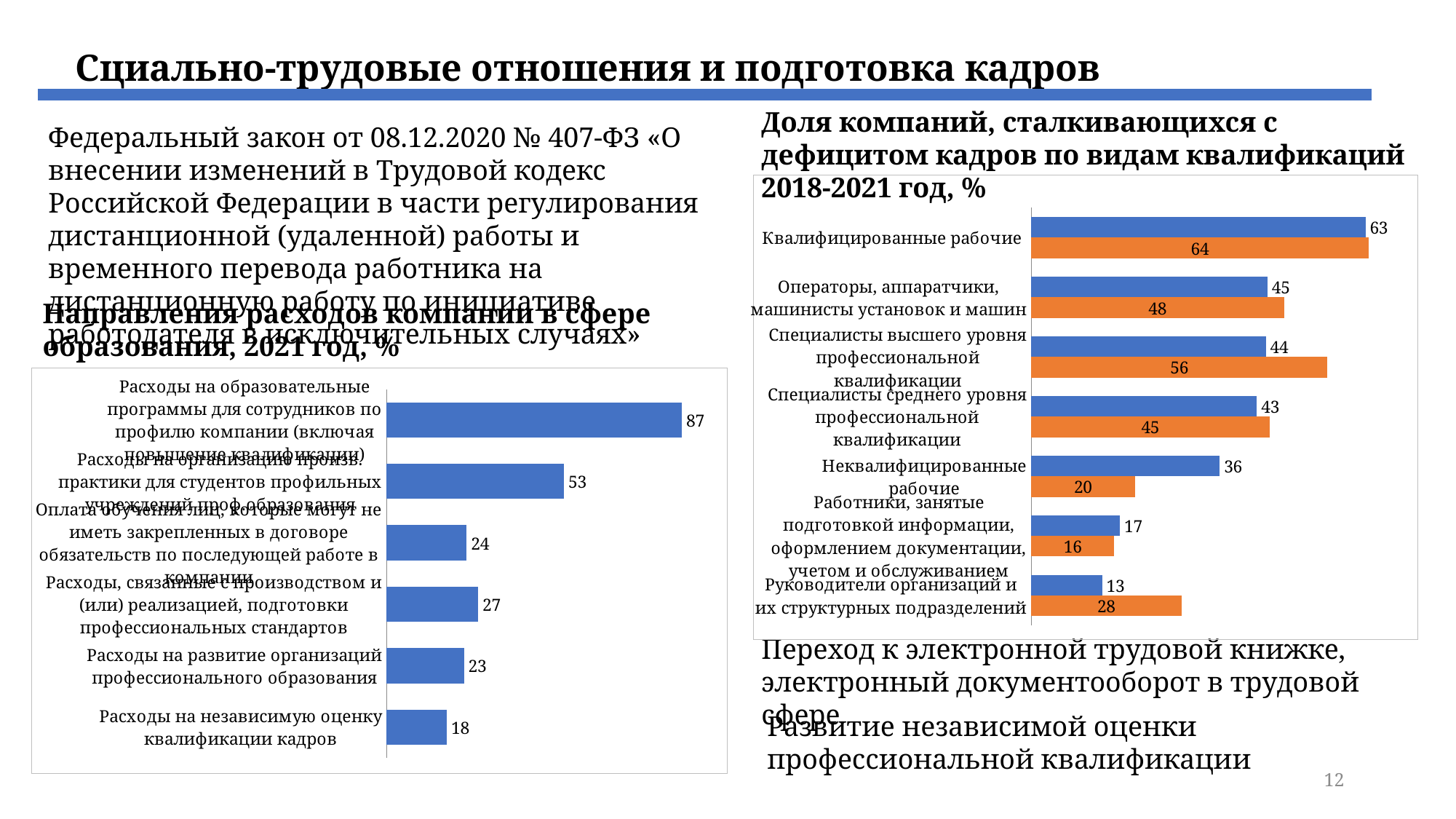
On the chart 'Направления расходов компаний в сфере образования, 2021 год, %', which category has the highest value? Расходы на образовательные программы для сотрудников по профилю компании (включая повышение квалификации) On the chart 'Направления расходов компаний в сфере образования, 2021 год, %', how many categories are shown? 6 On the chart 'Доля компаний, сталкивающихся с дефицитом кадров по видам квалификаций 2018-2021 год, %', what is the value of the orange bar for 'Квалифицированные рабочие'? 64 What type of chart is 'Доля компаний, сталкивающихся с дефицитом кадров по видам квалификаций 2018-2021 год, %'? Bar chart On the chart 'Доля компаний, сталкивающихся с дефицитом кадров по видам квалификаций 2018-2021 год, %', what is the difference between the orange (56) and blue (44) bars for 'Специалисты высшего уровня профессиональной квалификации'? 12 On the chart 'Направления расходов компаний в сфере образования, 2021 год, %', what is the difference between the highest value (87) and the value for 'Расходы, связанные с производством и (или) реализацией, подготовки профессиональных стандартов' (27)? 60 On the chart 'Доля компаний, сталкивающихся с дефицитом кадров по видам квалификаций 2018-2021 год, %', which is larger for 'Руководители организаций и их структурных подразделений': the blue bar or the orange bar? The orange bar On the chart 'Направления расходов компаний в сфере образования, 2021 год, %', what is the value for 'Расходы на независимую оценку квалификации кадров'? 18 On the chart 'Направления расходов компаний в сфере образования, 2021 год, %', which category has the lowest value? Расходы на независимую оценку квалификации кадров On the chart 'Доля компаний, сталкивающихся с дефицитом кадров по видам квалификаций 2018-2021 год, %', what is the value of the blue bar for 'Неквалифицированные рабочие'? 36 On the chart 'Доля компаний, сталкивающихся с дефицитом кадров по видам квалификаций 2018-2021 год, %', how many categories are shown? 7 On the chart 'Направления расходов компаний в сфере образования, 2021 год, %', what is the value for 'Расходы на развитие организаций профессионального образования'? 23